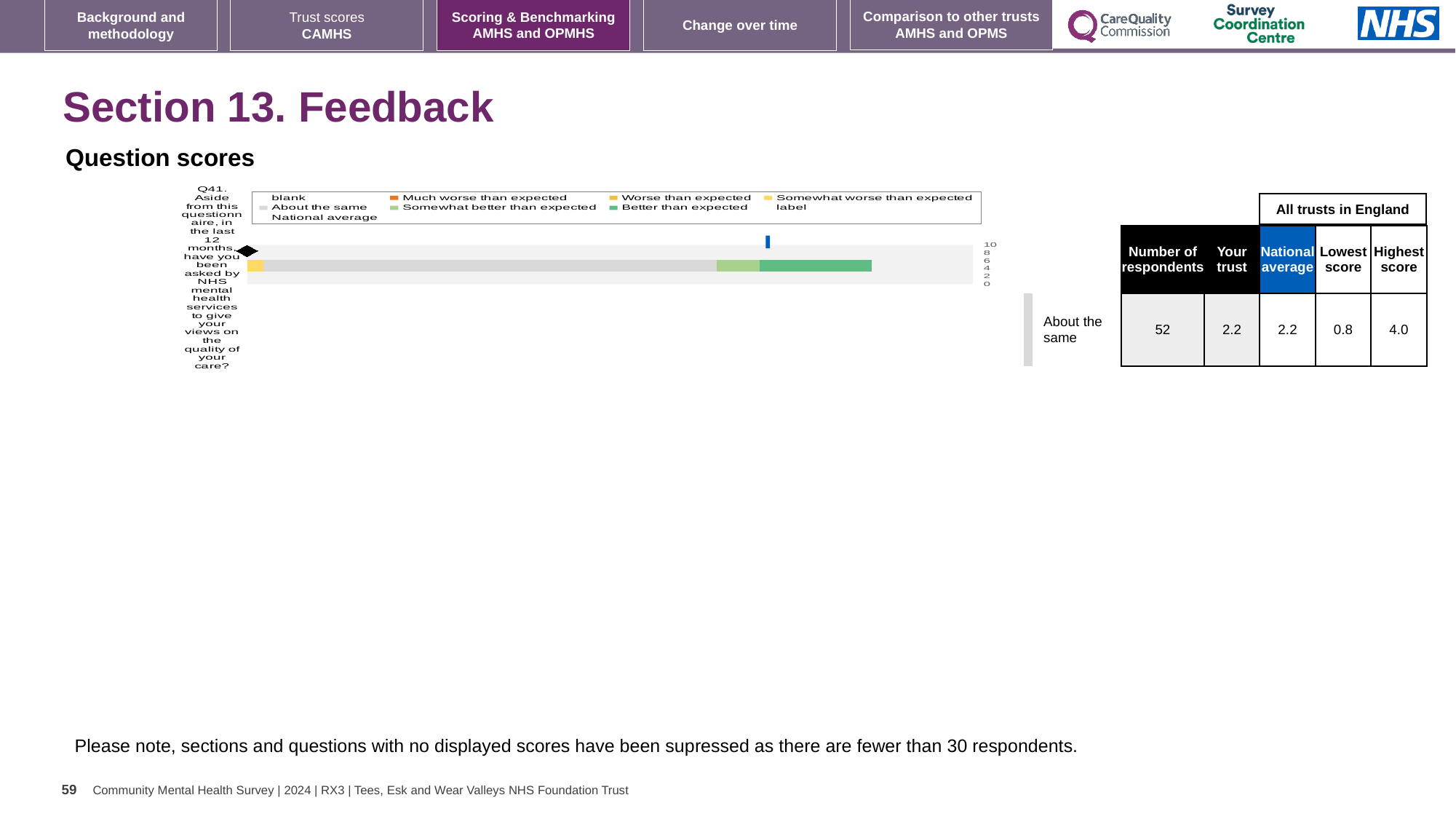
How many questions (categories) are plotted in the chart? 1 How many entries does the legend of the Q41 chart list? 9 In the table beside the chart, what is the highest score among all trusts in England for Q41? 4.0 Which legend entry of the chart is shown in dark green? Better than expected In the table beside the chart, what is the 'Your trust' score for Q41? 2.2 Which legend entry of the chart is shown in orange? Much worse than expected In the table beside the chart, what is the lowest score among all trusts in England for Q41? 0.8 In the table beside the chart, what is the national average score for Q41? 2.2 What kind of chart is used to show the Q41 question score? bar chart In the table beside the chart, what is the number of respondents for Q41? 52 What is the difference between the highest score and the lowest score for Q41 in the table beside the chart? 3.2 What benchmark category is shown next to the Q41 chart for this trust's result? About the same